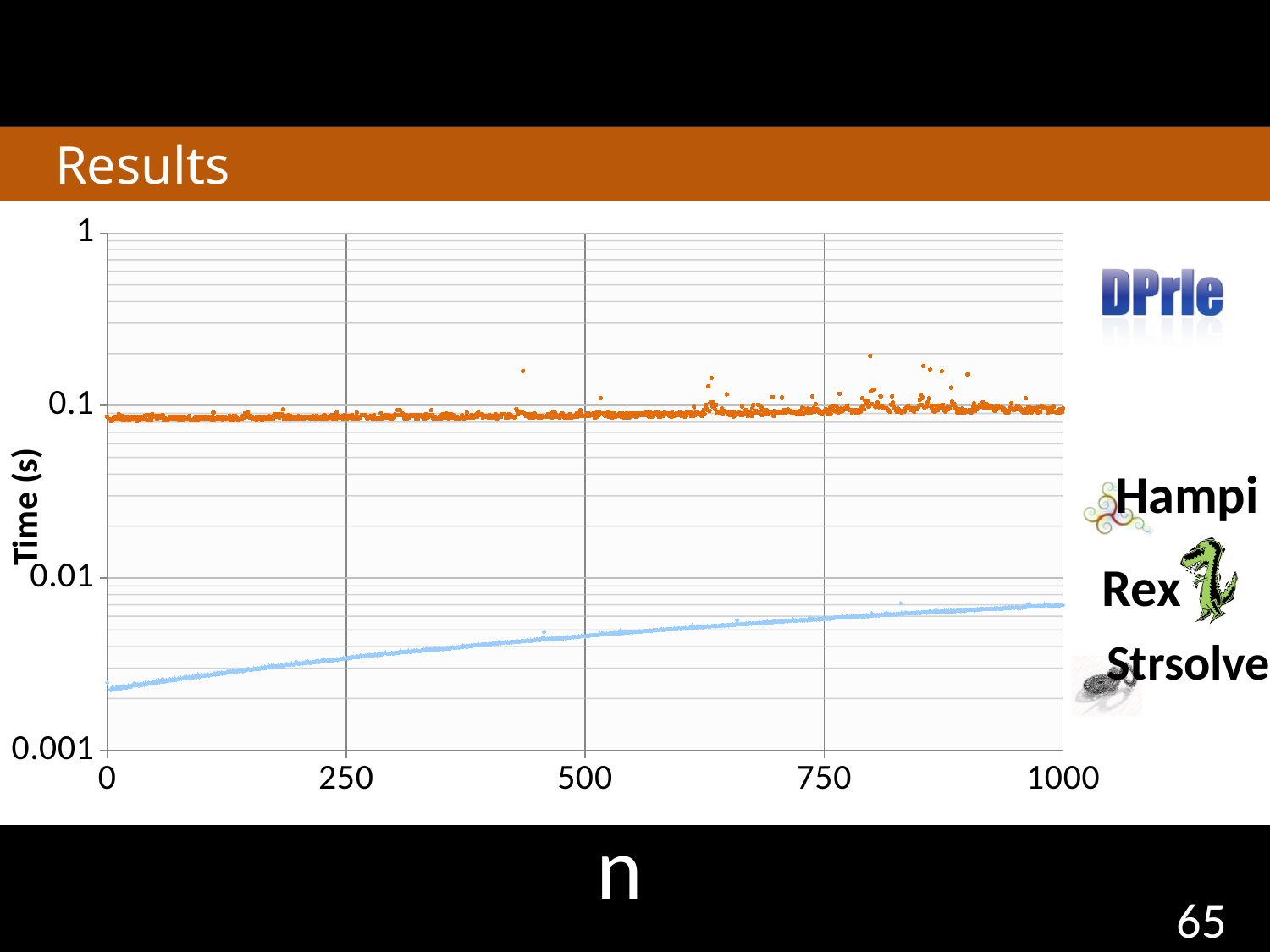
Which series has the higher time values across the chart, the orange series or the light blue series? the orange series What is the label of the horizontal axis? n Does the light blue series rise or fall as n increases from 0 to 1000? rise What kind of chart is shown on the slide? scatter chart Is the value of the light blue series at n = 500 greater or less than 0.01? less Is the value of the light blue series at n = 0 greater or less than 0.001? greater Is the value of the light blue series at n = 1000 greater or less than 0.01? less How many data series are plotted in the chart? 2 What is the title of the vertical axis? Time (s)